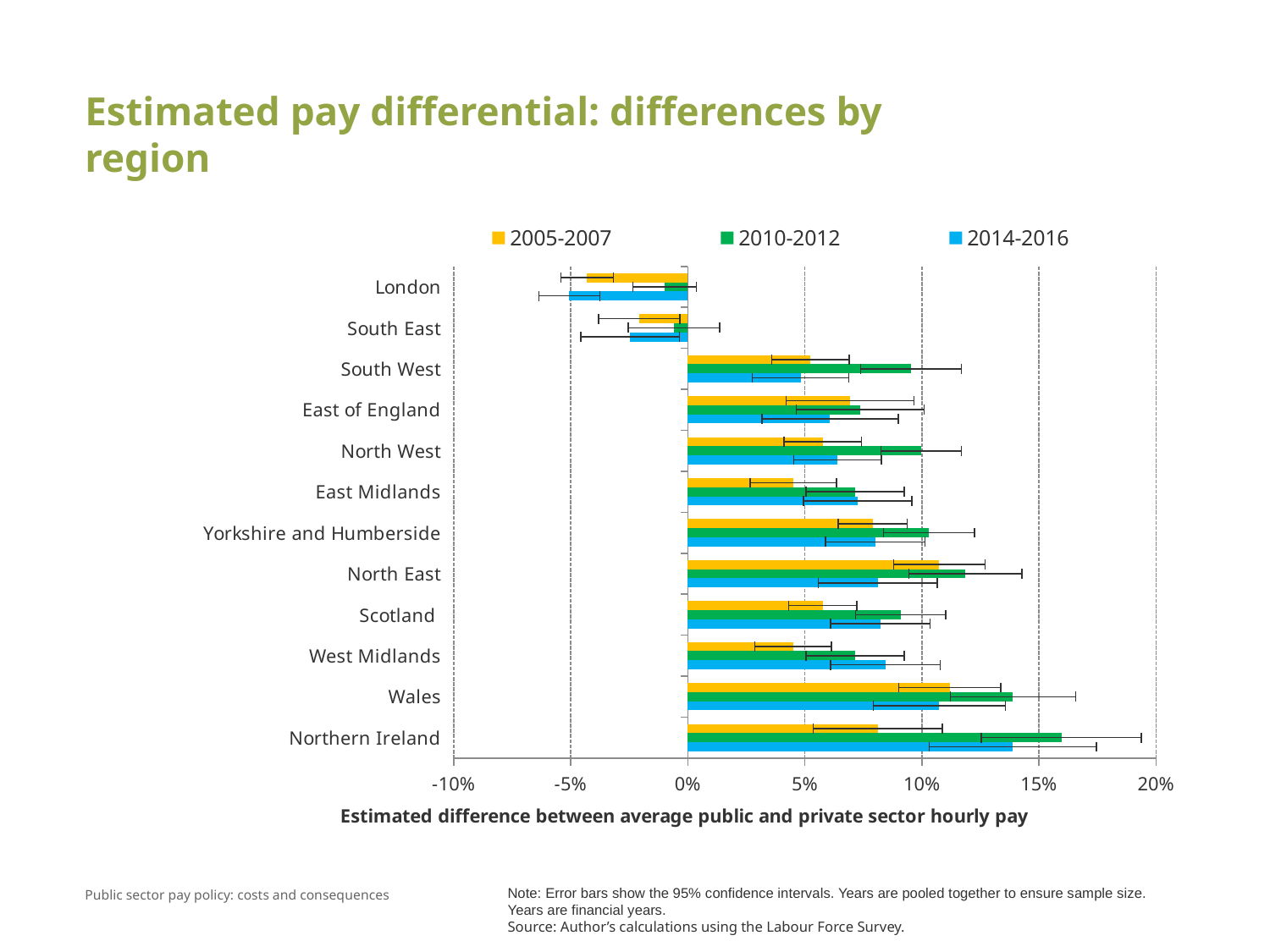
Is the 2010-2012 value for Northern Ireland greater or less than 15%? greater For South West, which series has the larger value: 2005-2007 or 2010-2012? 2010-2012 Is the 2005-2007 value for London greater or less than 0%? less Which region has the lowest value for the 2005-2007 series? London What is the title of the horizontal axis? Estimated difference between average public and private sector hourly pay How many regions are shown on the chart? 12 For the 2005-2007 series, which region has the larger value: Wales or Scotland? Wales Which region has the highest value for the 2010-2012 series? Northern Ireland How many series does the legend list? 3 Is the 2010-2012 value for Wales greater or less than 10%? greater What kind of chart is shown on the slide? Bar chart Which region has the highest value for the 2014-2016 series? Northern Ireland